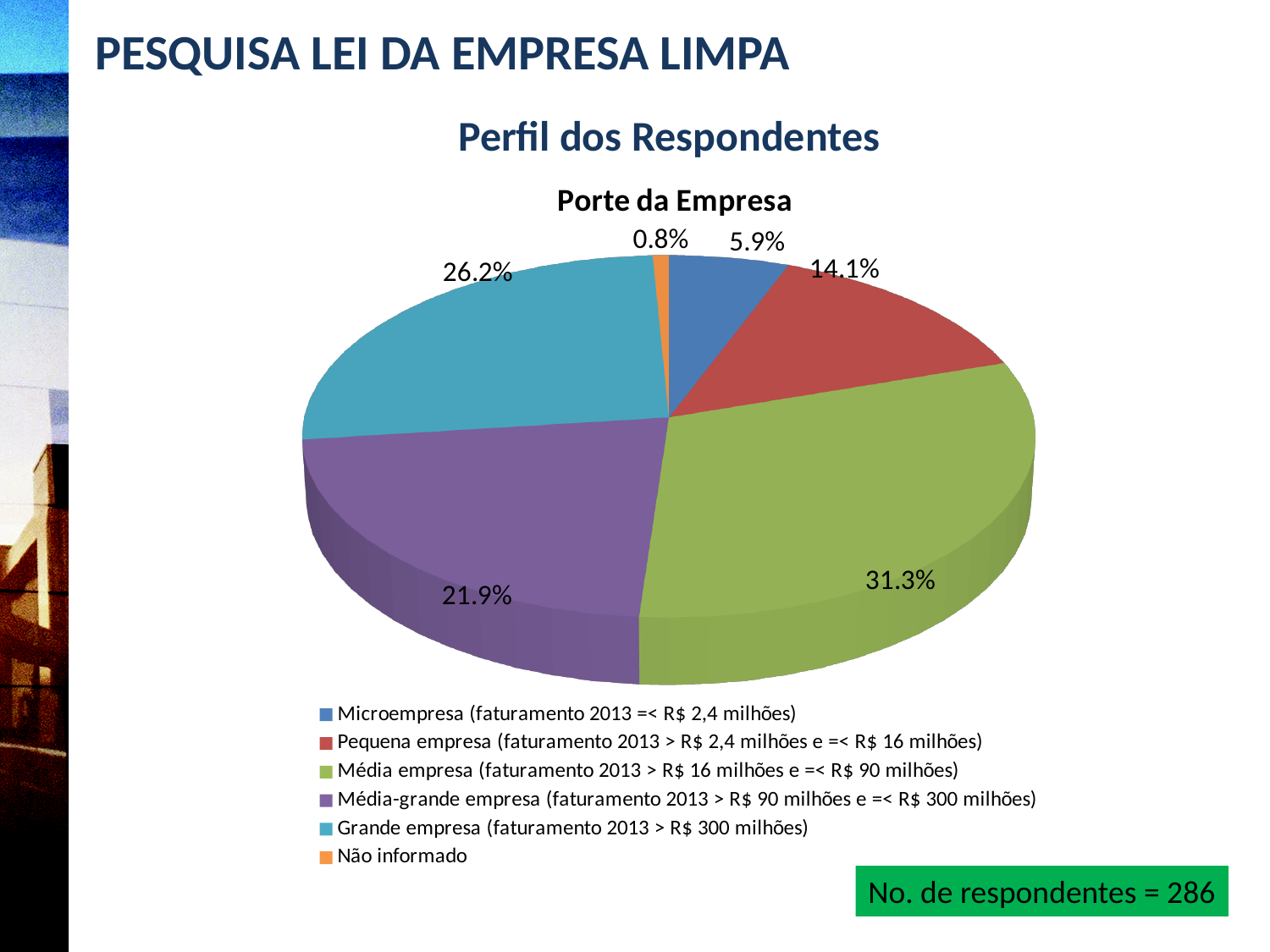
What share of respondents are Pequena empresa (faturamento 2013 > R$ 2,4 milhões e =< R$ 16 milhões)? 14.1% What share of respondents are Microempresa (faturamento 2013 =< R$ 2,4 milhões)? 5.9% What colour is the slice for Média-grande empresa? purple What share of respondents are in the Não informado category? 0.8% How many categories does the pie chart have? 6 What kind of chart is shown under the title "Porte da Empresa"? pie chart What is the difference in percentage points between the Média empresa share and the Média-grande empresa share? 9.4 Which is larger: the share for Grande empresa or the share for Média-grande empresa? Grande empresa Which company size category has the largest share of respondents? Média empresa (faturamento 2013 > R$ 16 milhões e =< R$ 90 milhões) Which category has the smallest slice of the pie? Não informado What share of respondents are Média empresa (faturamento 2013 > R$ 16 milhões e =< R$ 90 milhões)? 31.3% What share of respondents are Grande empresa (faturamento 2013 > R$ 300 milhões)? 26.2%